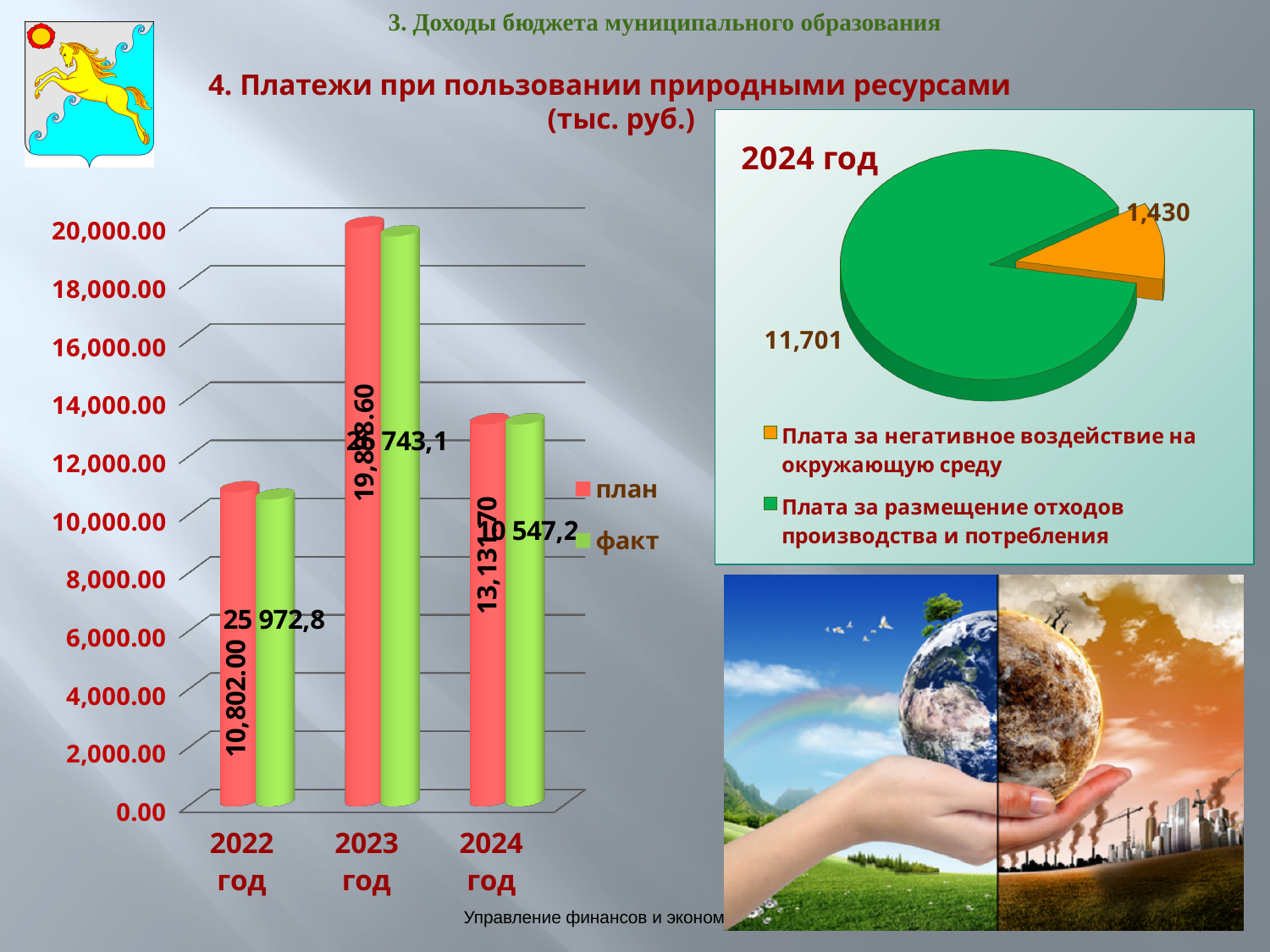
In the bar chart on the left, what is the план value for 2022 год? 10,802.00 What kind of chart is the chart on the left showing план and факт by year? bar chart In the bar chart on the left, which year has the lowest план value? 2022 год In the bar chart on the left, is the план value for 2024 год greater or less than 12,000.00? greater In the bar chart on the left, is the факт value for 2022 год greater or less than 12,000.00? less In the pie chart titled 2024 год, what is the value for Плата за негативное воздействие на окружающую среду? 1,430 In the pie chart titled 2024 год, what is the value for Плата за размещение отходов производства и потребления? 11,701 In the bar chart on the left, which is larger: the план value for 2023 год or for 2024 год? 2023 год In the bar chart on the left, how many years are shown on the x axis? 3 In the bar chart on the left, how many series does the legend list? 2 In the pie chart titled 2024 год, what is the difference between the two slices, 11,701 and 1,430? 10,271 In the bar chart on the left, which year has the highest план value? 2023 год